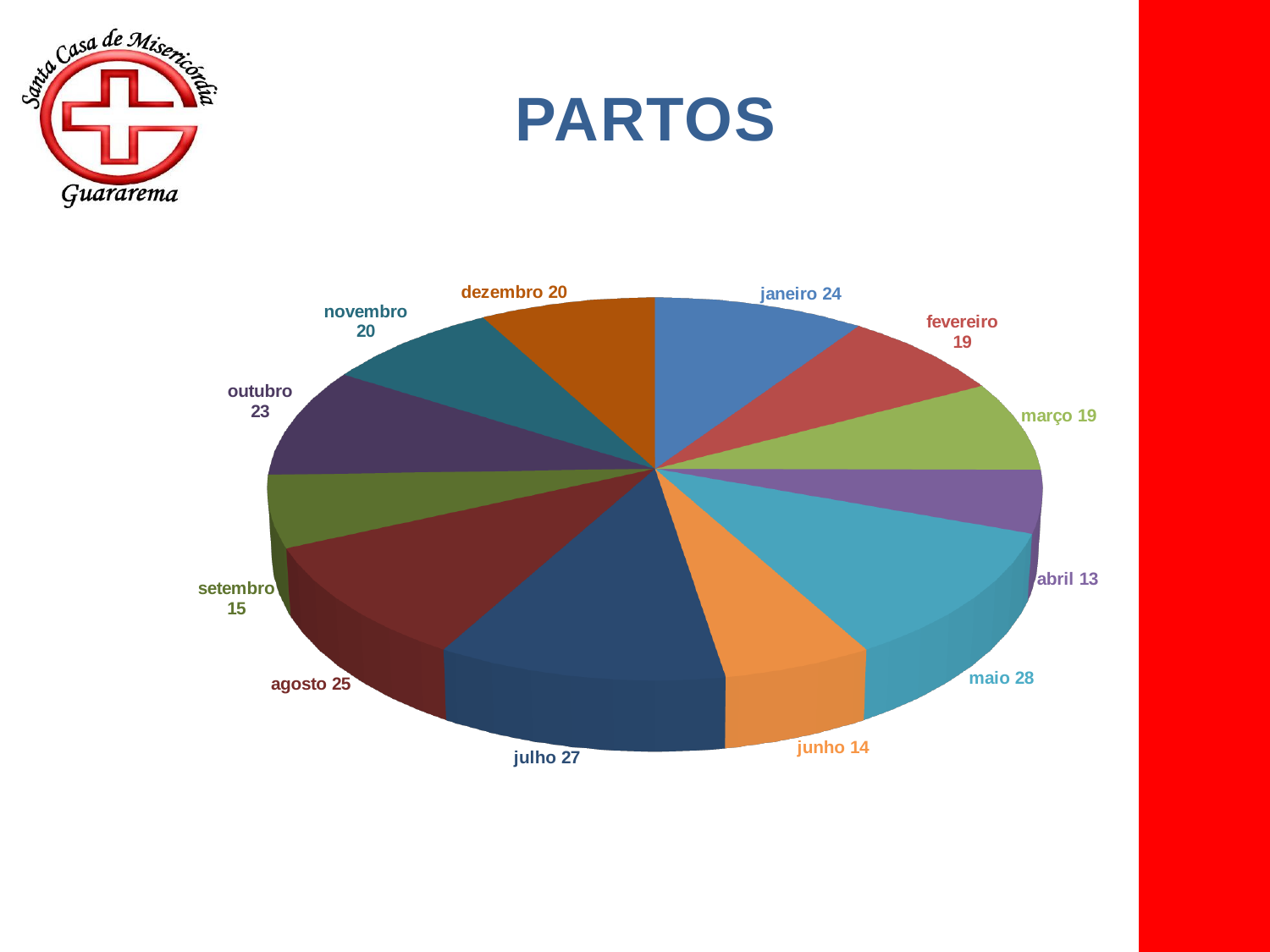
What is the title of the chart? PARTOS What is the value for outubro? 23 What is the value for maio? 28 What is the value for abril? 13 What is the total of all the values shown in the pie chart? 247 Which month has the lowest value? abril How many categories (months) does the pie chart show? 12 Which is larger, the value for julho or the value for agosto? julho What kind of chart is shown on the slide? pie chart What is the value for setembro? 15 Which month has the highest value? maio What is the difference between the values for maio and abril? 15